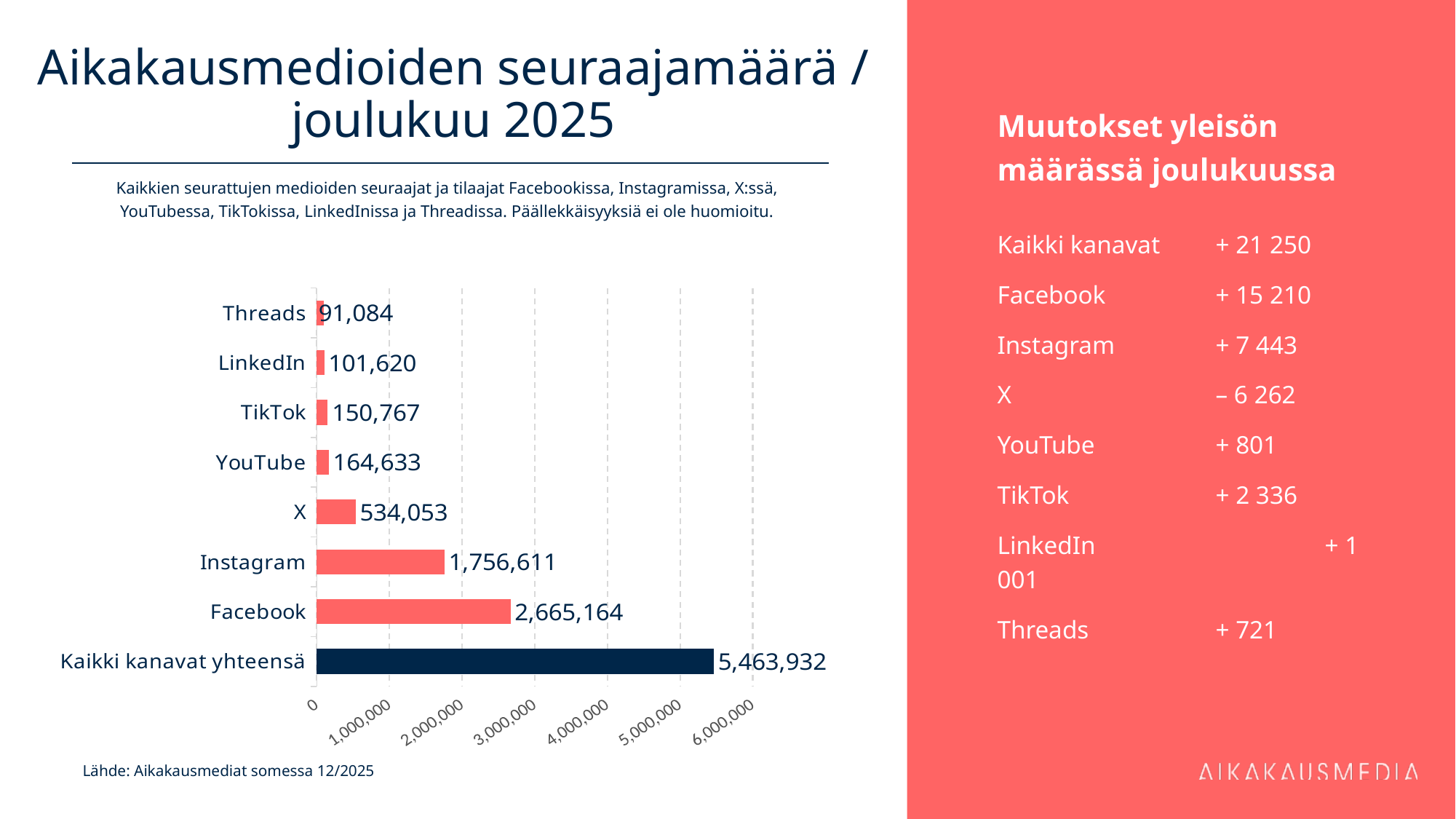
Which category has the lowest value in the chart? Threads What is the value for Facebook in the chart? 2,665,164 What is the difference between the values for Facebook and Instagram? 908,553 Which has a larger value, X or YouTube? X What kind of chart is shown on the slide? Bar chart What is the value for Instagram in the chart? 1,756,611 What is the value shown for Kaikki kanavat yhteensä? 5,463,932 What is the value for Threads in the chart? 91,084 What is the difference between the values for YouTube and TikTok? 13,866 Excluding the total bar (Kaikki kanavat yhteensä), which channel has the highest value? Facebook How many bars are shown in the chart? 8 What is the value for X in the chart? 534,053